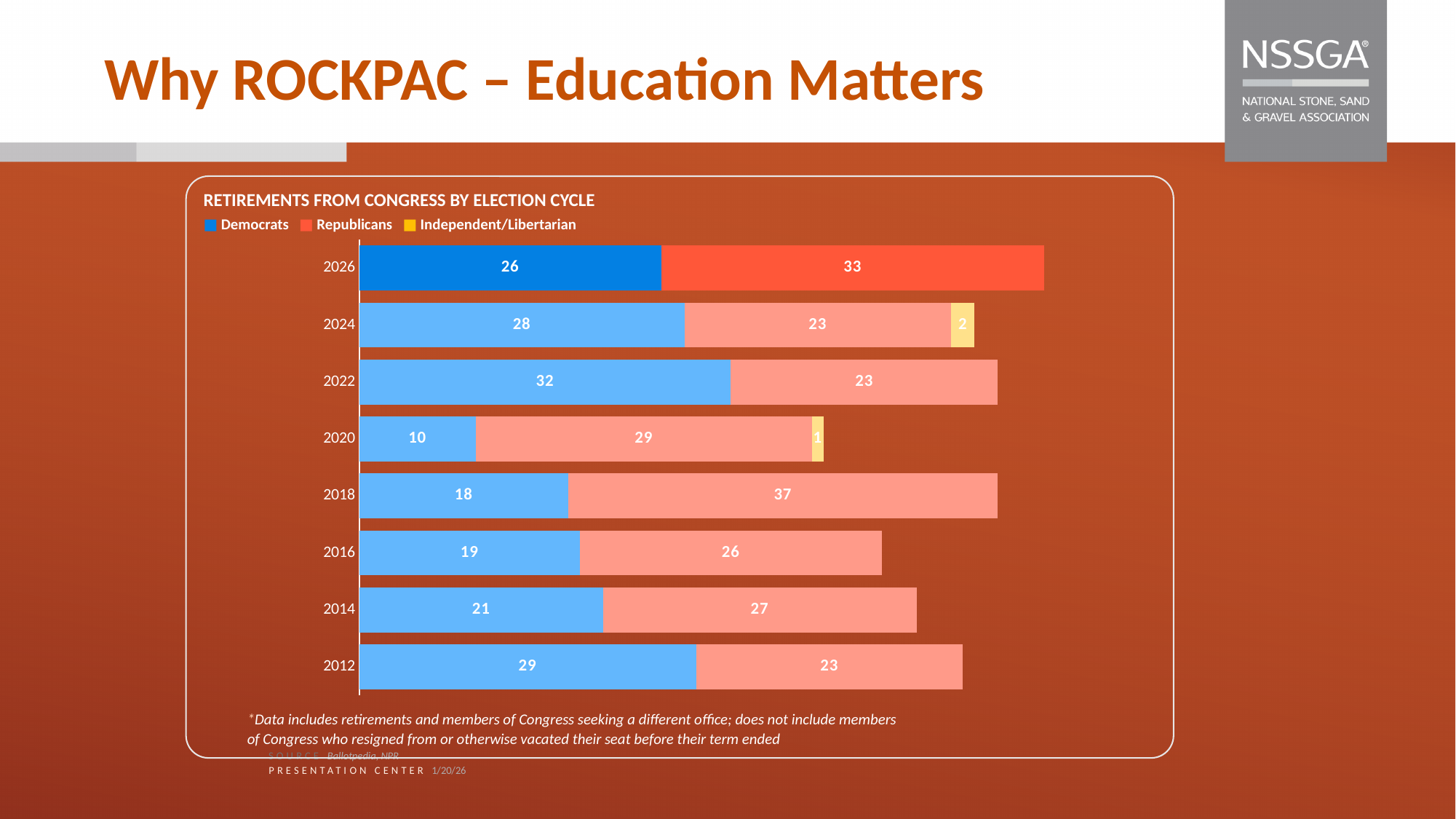
What is the Independent/Libertarian value for 2024? 2 How many Republicans retired in the 2018 election cycle? 37 What is the difference between Republican and Democrat retirements in 2020? 19 In 2012, which party had more retirements, Democrats or Republicans? Democrats What type of chart is shown on the slide? Stacked bar chart How many Democrats retired in the 2026 election cycle? 26 How many series does the legend list? 3 How many election cycles are shown on the chart? 8 Which election cycle has the highest number of Democrat retirements? 2022 Which election cycle has the highest number of Republican retirements? 2018 Which election cycle has the lowest number of Democrat retirements? 2020 What is the total number of retirements shown for the 2024 election cycle? 53